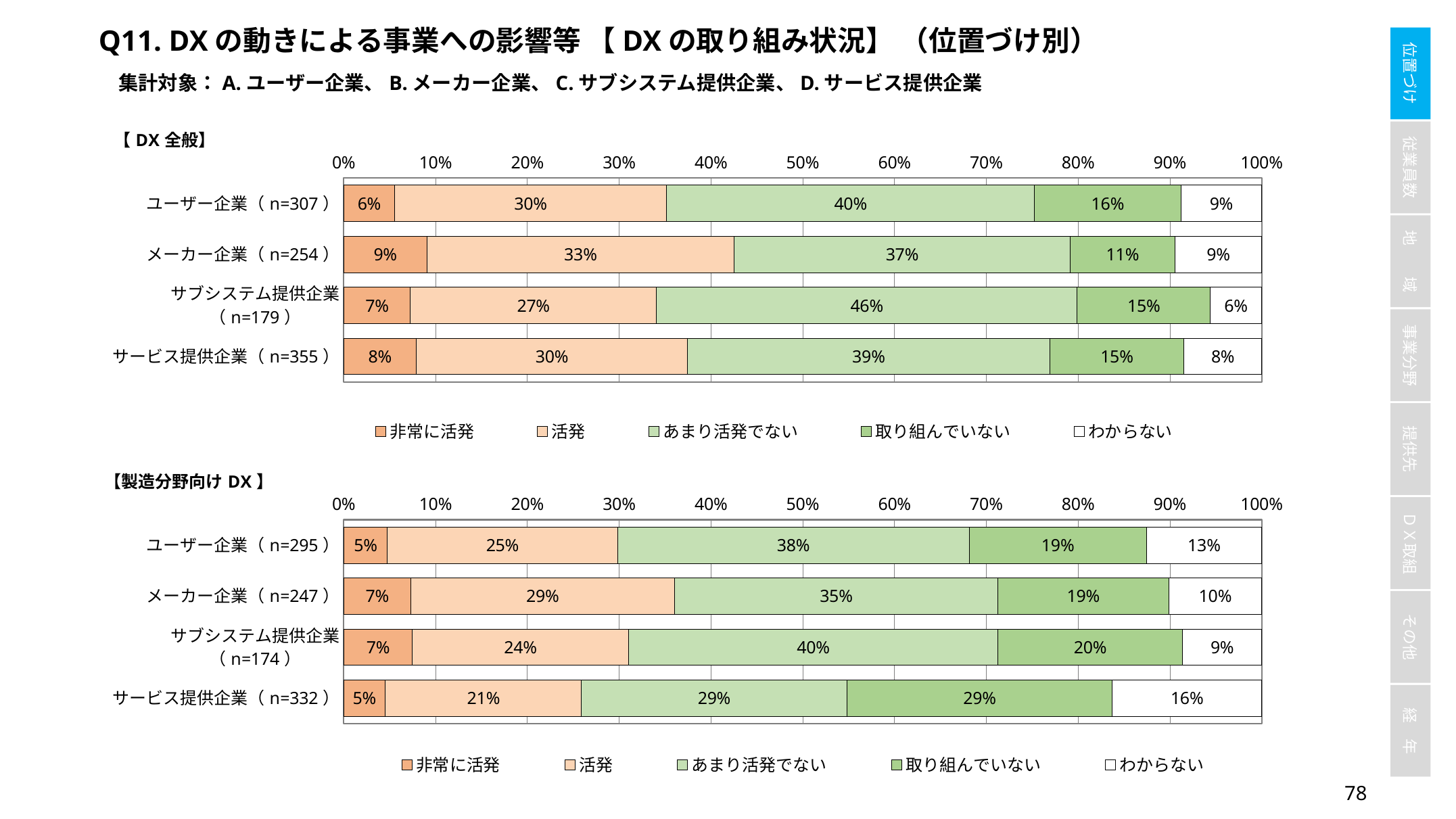
In the 【製造分野向けDX】 chart, what is the sample size (n) for メーカー企業? 247 What kind of chart is the 【DX全般】 chart? Stacked bar chart In the 【DX全般】 chart, what is the value of あまり活発でない for サブシステム提供企業? 46% How many series does the legend of the 【DX全般】 chart list? 5 In the 【製造分野向けDX】 chart, what is the value of 取り組んでいない for サブシステム提供企業? 20% In the 【DX全般】 chart, what is the difference between the 活発 values for メーカー企業 and サブシステム提供企業? 6% In the 【製造分野向けDX】 chart, which is larger: あまり活発でない for ユーザー企業 or for サービス提供企業? ユーザー企業 In the 【DX全般】 chart, which category has the highest value for 取り組んでいない? ユーザー企業 How many categories are shown in the 【製造分野向けDX】 chart? 4 In the 【DX全般】 chart, what is the value of 非常に活発 for メーカー企業? 9% In the 【製造分野向けDX】 chart, which category has the lowest value for 活発? サービス提供企業 In the 【製造分野向けDX】 chart, what is the value of わからない for サービス提供企業? 16%